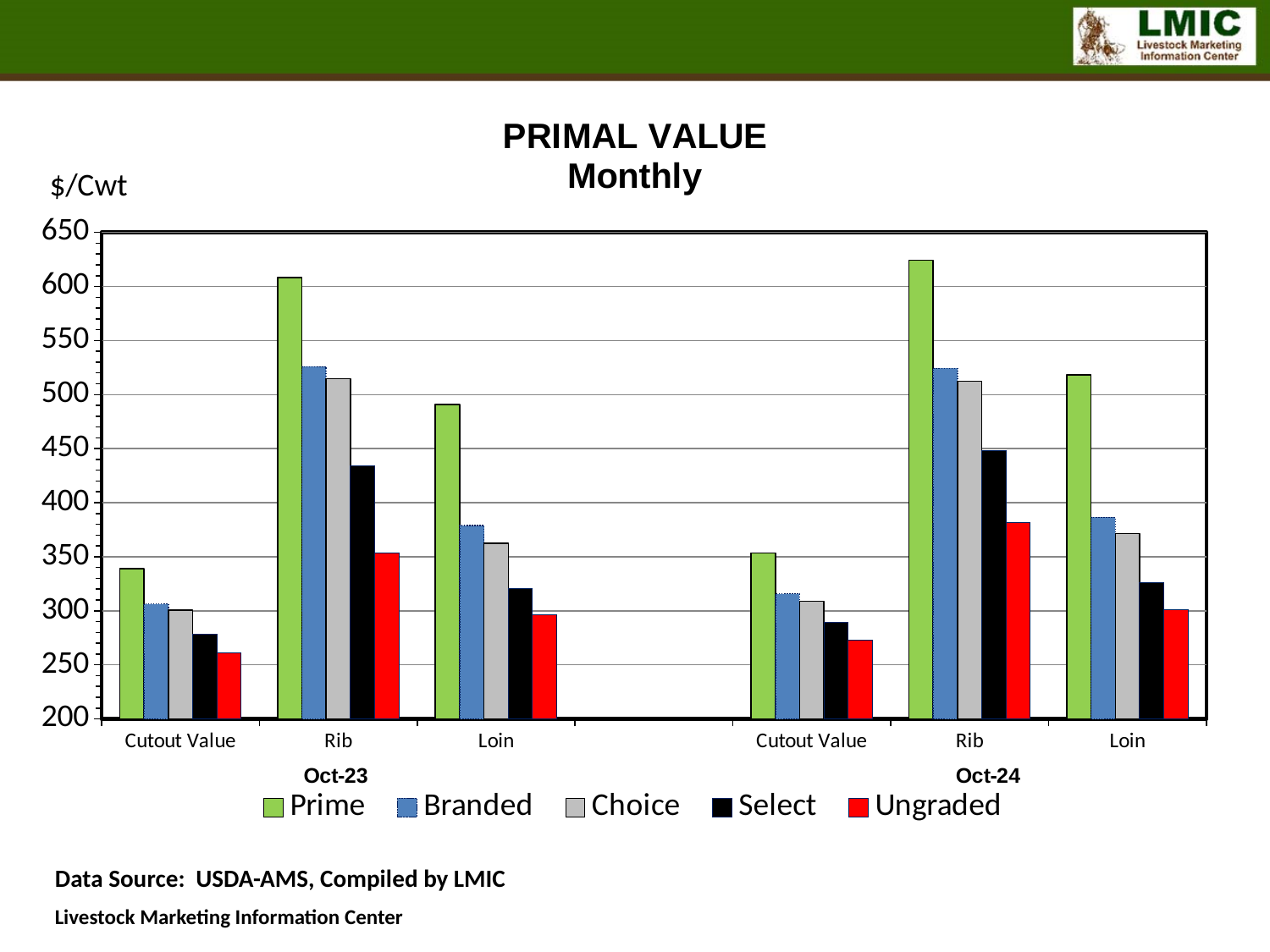
Is the Prime value for Rib in Oct-23 greater or less than 550? greater Which series has the tallest bar in every group? Prime What unit is shown on the y axis? $/Cwt Which is larger for Select in Oct-23, Rib or Loin? Rib How many groups of bars are plotted along the x axis? 6 Which is larger, the Prime value for Rib in Oct-23 or the Prime value for Rib in Oct-24? Oct-24 How many series does the legend list? 5 Which bar is the lowest on the whole chart? Ungraded, Cutout Value, Oct-23 Is the Ungraded value for Cutout Value in Oct-24 greater or less than 300? less What kind of chart is shown on the slide? bar chart Is the Ungraded value for Rib in Oct-23 greater or less than 400? less